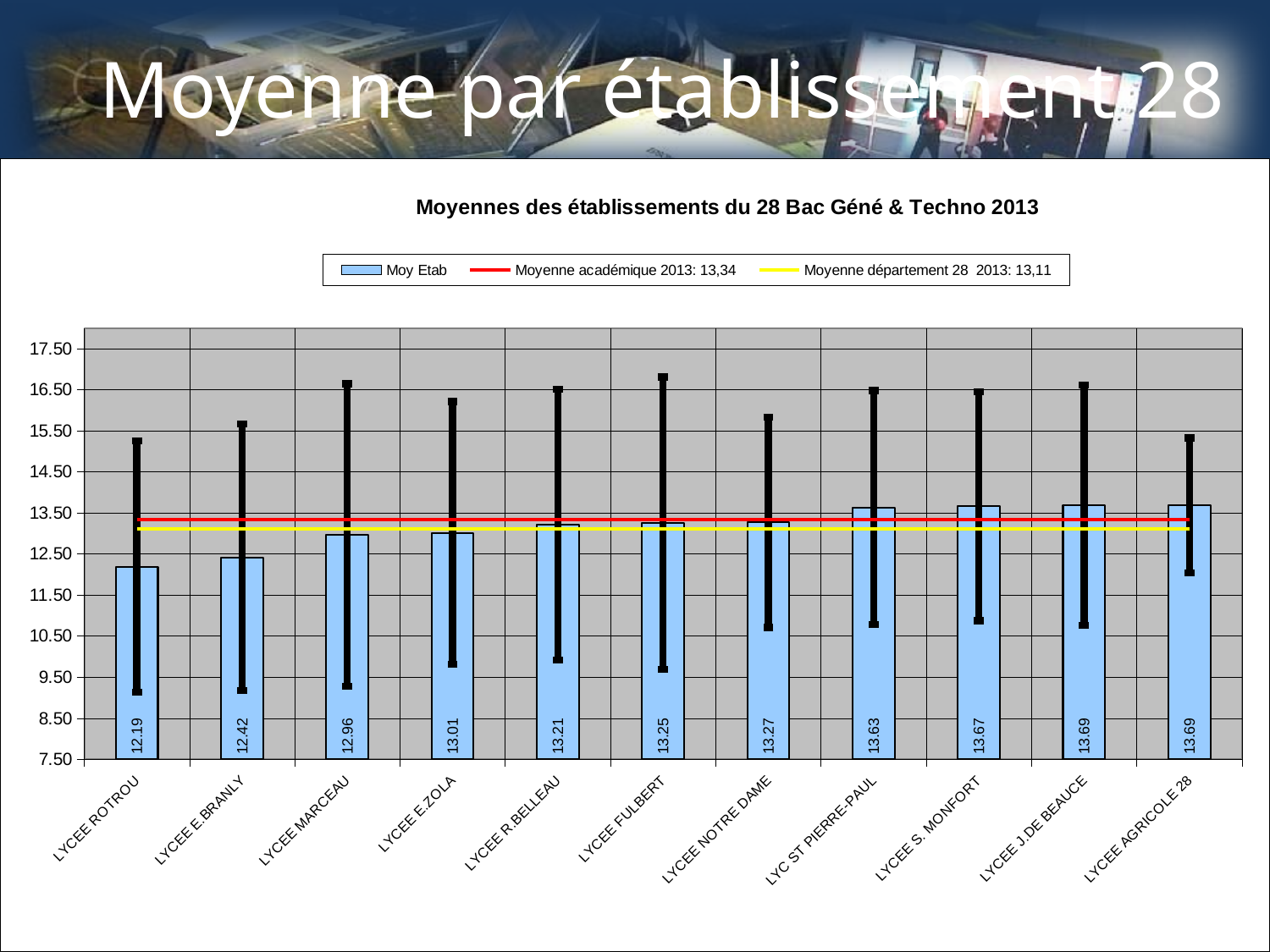
What kind of chart is this? bar chart Which establishment has the lowest value? LYCEE ROTROU What is the difference between the values for LYCEE FULBERT and LYCEE E.BRANLY? 0.83 What is the title of the chart? Moyennes des établissements du 28 Bac Géné & Techno 2013 How many entries does the legend list? 3 What is the value for LYCEE S. MONFORT? 13.67 What is the value for LYCEE NOTRE DAME? 13.27 How many establishments are shown on the x axis? 11 Which is larger, the value for LYCEE E.ZOLA or the value for LYC ST PIERRE-PAUL? LYC ST PIERRE-PAUL What is the value for LYCEE ROTROU? 12.19 Do the bar values rise or fall from left to right along the x axis? rise What is the value for LYCEE MARCEAU? 12.96